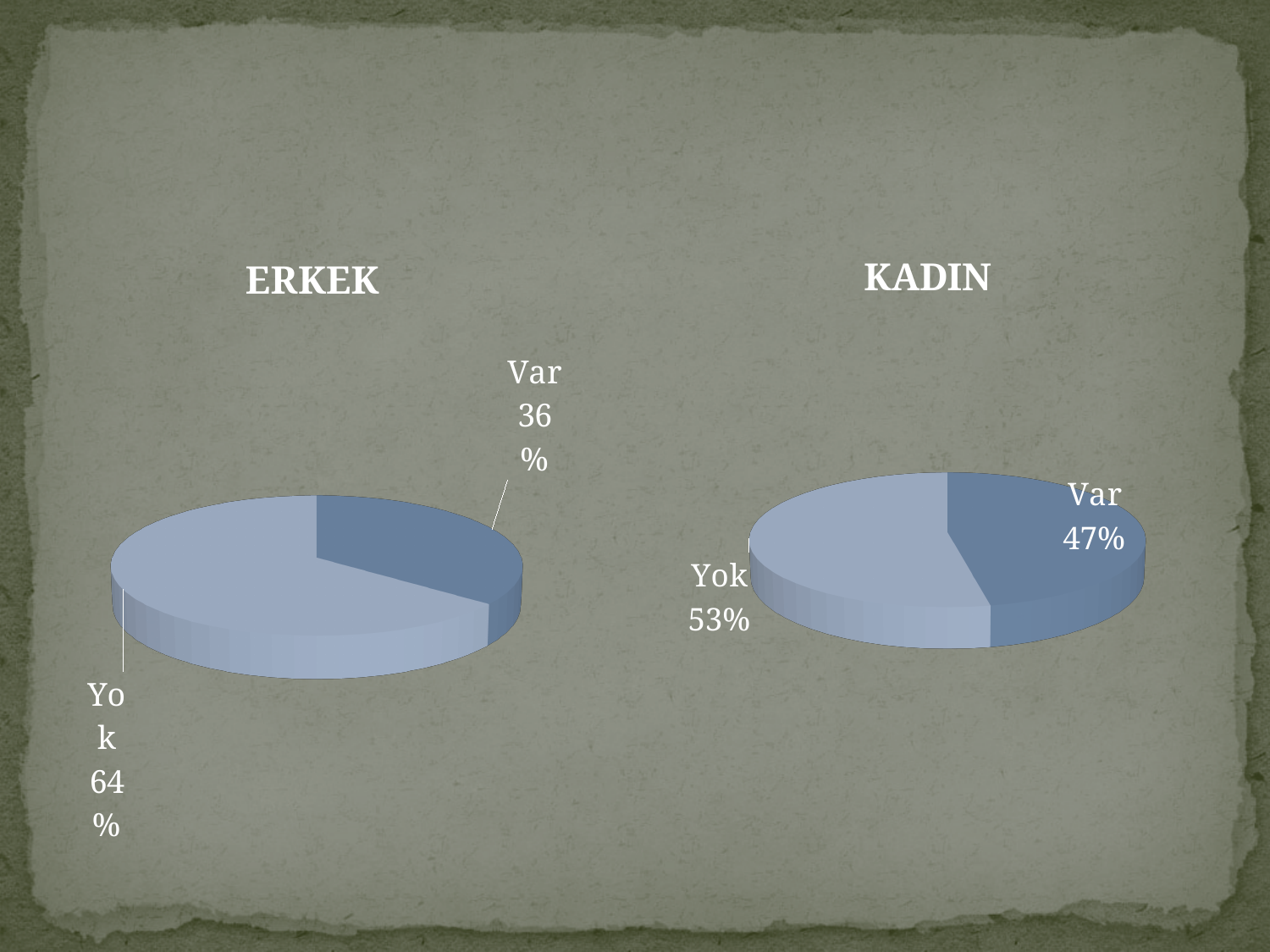
In the KADIN chart, what share does the Yok slice have? 53% What kind of chart is the KADIN chart? Pie chart Which chart has the larger Var share, ERKEK or KADIN? KADIN In the ERKEK chart, what share does the Yok slice have? 64% In the ERKEK chart, which slice is the largest? Yok In the KADIN chart, which slice is the smallest? Var What is the title of the chart on the left side of the slide? ERKEK In the ERKEK chart, what share does the Var slice have? 36% How many slices does the ERKEK chart have? 2 In the KADIN chart, what is the difference between the Yok and Var shares? 6% In the ERKEK chart, what is the difference between the Yok and Var shares? 28%